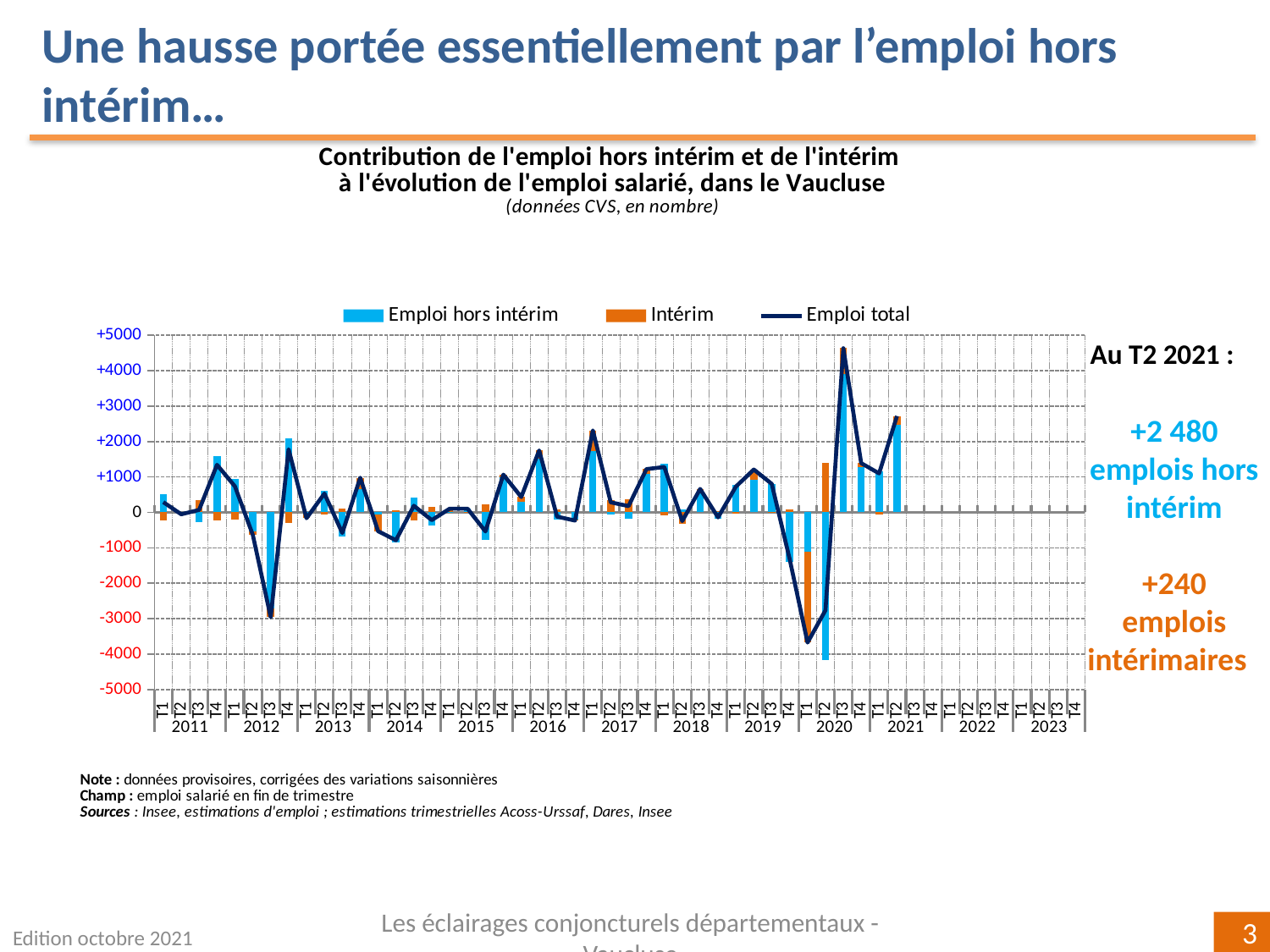
What colour are the Intérim bars in the chart? Orange What is the combined contribution of Emploi hors intérim and Intérim at T2 2021? +2 720 According to the slide, what is the value for Emploi hors intérim at T2 2021? +2 480 Is the value of Emploi hors intérim at T2 2020 greater or less than -3000? less Is the value of Emploi total at T1 2020 greater or less than -3000? less In which quarter does the Emploi total line reach its highest value? T3 2020 Is the value of Emploi total at T3 2020 greater or less than +4000? greater In which quarter does the Emploi total line reach its lowest value? T1 2020 What kind of chart is shown on the slide? Combined bar and line chart At T2 2021, which is larger: Emploi hors intérim or Intérim? Emploi hors intérim According to the slide, what is the value for Intérim at T2 2021? +240 How many series does the chart legend list? 3